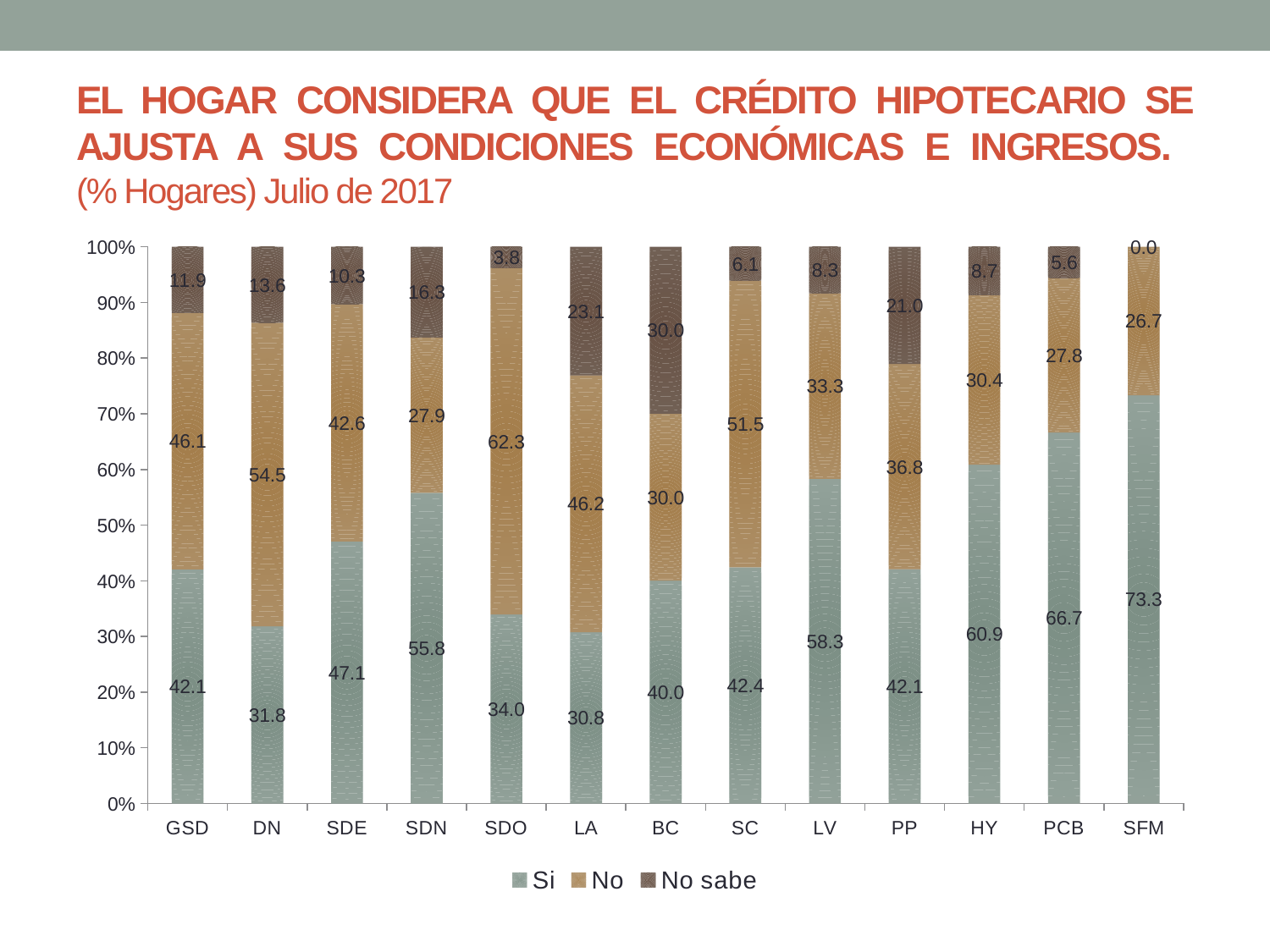
Which category has the highest "No sabe" value? BC Which category has the highest "Si" value? SFM How many categories are shown on the x axis? 13 Which category has the lowest "Si" value? LA What is the value of the "No" series for SDO? 62.3 What is the value of the "No sabe" series for LA? 23.1 What is the difference between the "No" value for DN and the "No" value for SDN? 26.6 What is the value of the "No sabe" series for SFM? 0.0 Which is larger: the "Si" value for HY or the "Si" value for LV? HY What is the value of the "Si" series for SFM? 73.3 What kind of chart is shown on the slide? Stacked bar chart How many series does the legend list? 3